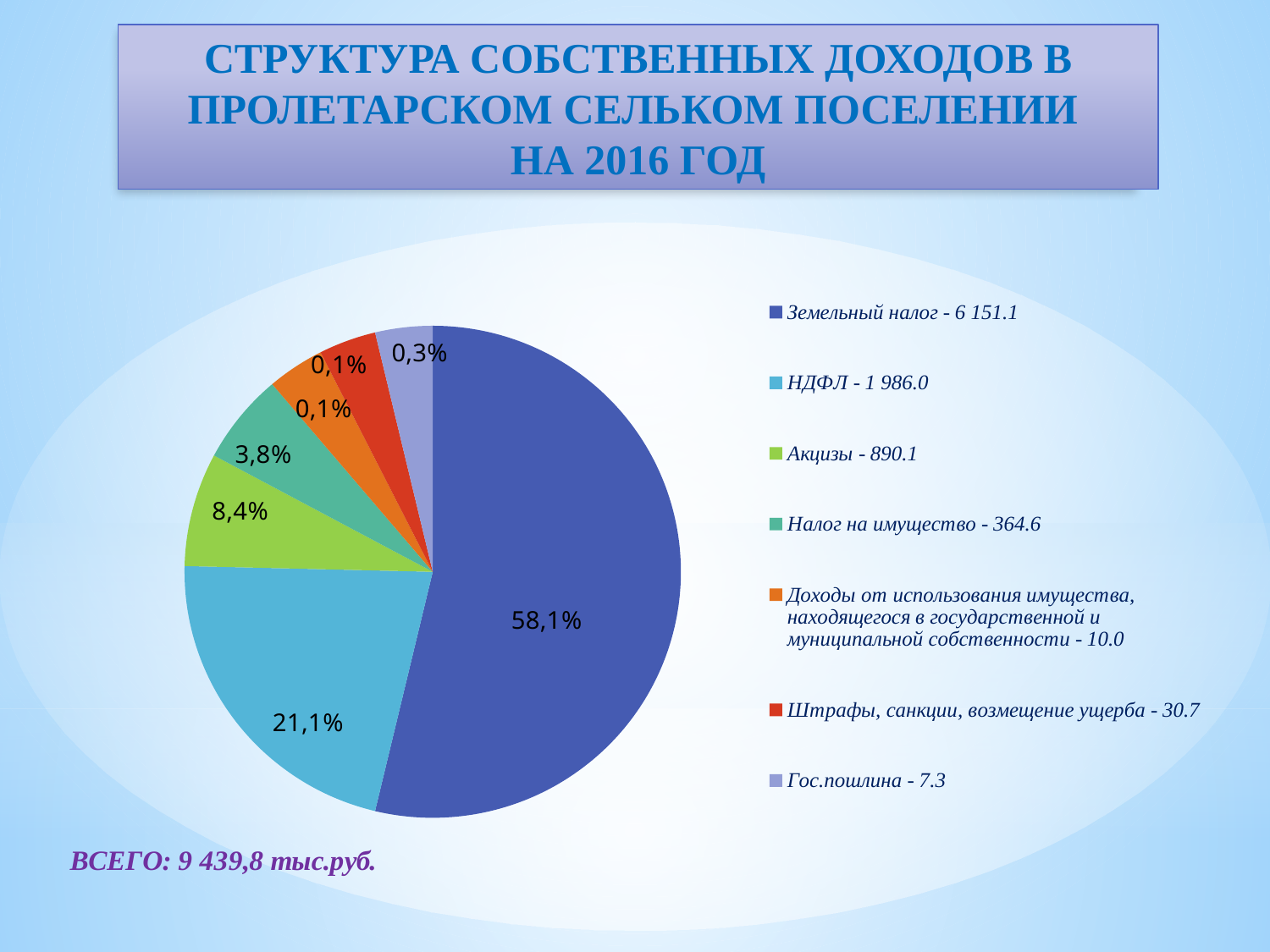
What share of the pie does Гос.пошлина take? 0,3% What is the difference in percentage points between the Земельный налог slice and the НДФЛ slice? 37,0% What total amount is stated below the chart? 9 439,8 тыс.руб. What share of the pie does Акцизы take? 8,4% What kind of chart is shown on the slide? pie chart Which slice is larger, Акцизы or Налог на имущество? Акцизы What value is given for Акцизы in the legend? 890.1 Which category has the largest slice of the pie? Земельный налог What share of the pie does Земельный налог take? 58,1% How many slices does the pie chart have? 7